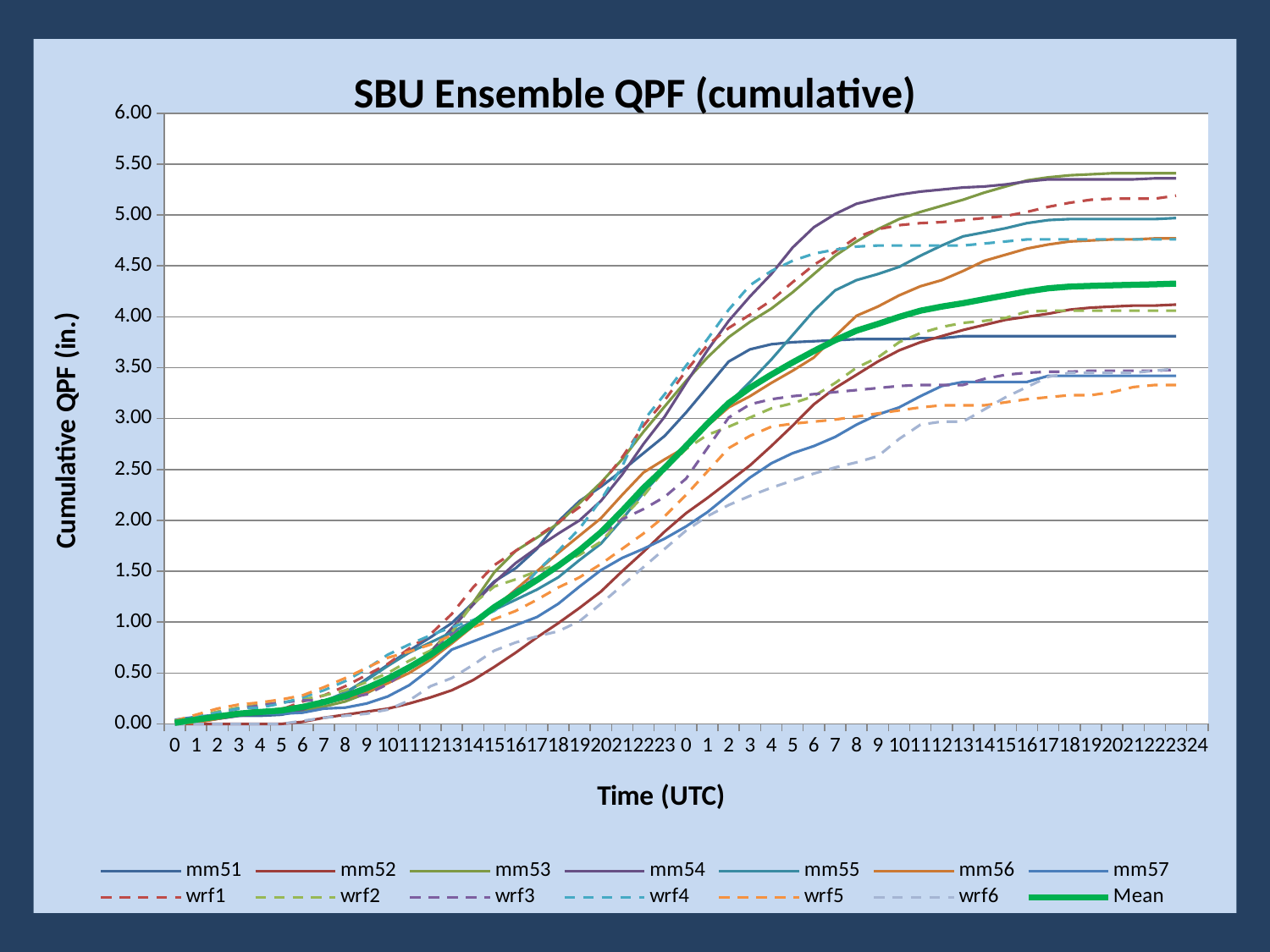
What is the label of the y axis? Cumulative QPF (in.) Is the final value of mm51 greater or less than 4.00? less What is the title of the chart? SBU Ensemble QPF (cumulative) Do the plotted values rise or fall along the x axis? rise Is the final value of mm56 greater or less than 4.50? greater Is the final value of the Mean series greater or less than 4.50? less At the end of the period, which is higher, the Mean or mm51? Mean How many series does the legend list? 14 What kind of chart is shown on the slide? line chart At the end of the period, which is higher, mm54 or mm51? mm54